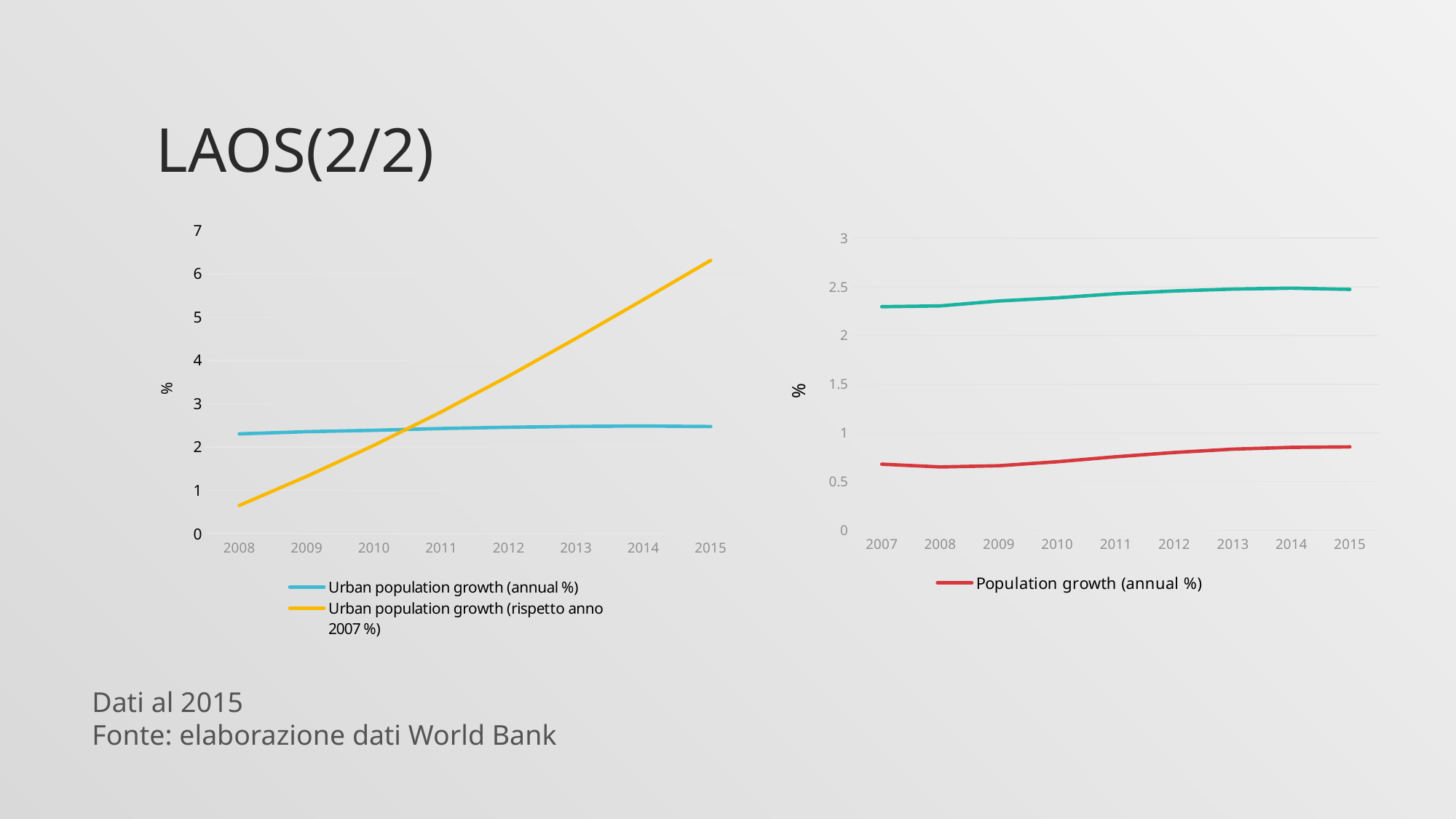
How many series does the legend of the right chart list? 1 What kind of chart is the left chart on the slide? line chart In the left chart, is the value of 'Urban population growth (rispetto anno 2007 %)' in 2015 greater or less than 6? greater In the left chart, which series has the higher value in 2015? Urban population growth (rispetto anno 2007 %) In the right chart, is the value of 'Population growth (annual %)' in 2015 greater or less than 1? less How many years are shown on the x axis of the left chart? 8 In the left chart, is the value of 'Urban population growth (annual %)' in 2008 greater or less than 2? greater In the left chart, does the 'Urban population growth (rispetto anno 2007 %)' line rise or fall from 2008 to 2015? rise In the left chart, in which year does 'Urban population growth (rispetto anno 2007 %)' reach its highest value? 2015 How many series does the legend of the left chart list? 2 How many years are shown on the x axis of the right chart? 9